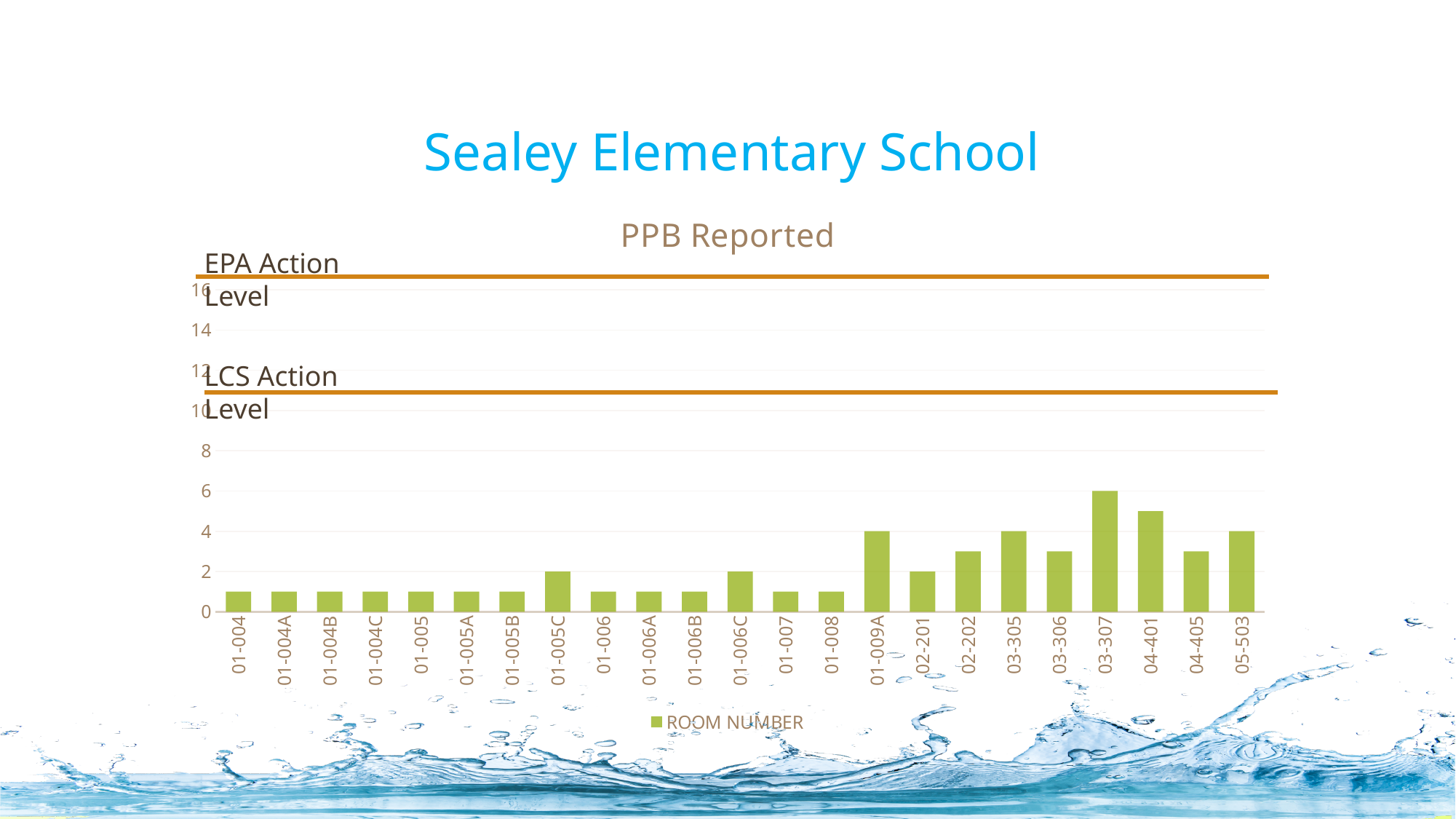
How many series does the legend list? 1 What are the two labelled horizontal lines drawn above the bars? EPA Action Level and LCS Action Level What is the title of the chart? PPB Reported What is the PPB reported value for room 03-307? 6 Is the value for room 04-401 greater or less than 4? greater What is the PPB reported value for room 01-009A? 4 Which room number has the highest PPB reported value? 03-307 What is the PPB reported value for room 02-201? 2 How many room number categories are plotted on the x axis? 23 Which has a larger value, room 03-307 or room 04-401? 03-307 What type of chart is shown on the slide? bar chart What is the difference between the values for room 03-307 and room 05-503? 2